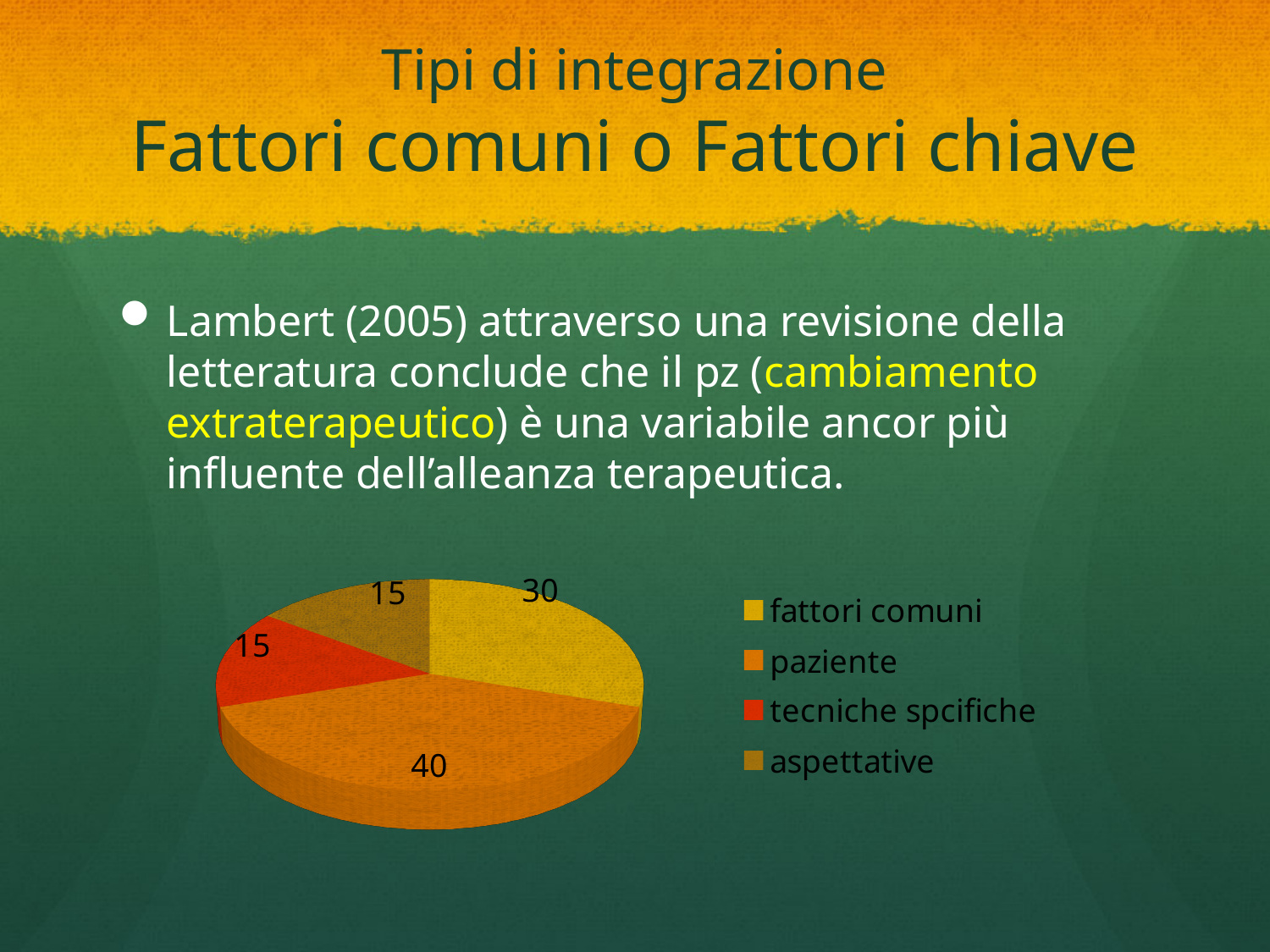
What share of the pie does the paziente slice represent? 40% What kind of chart is shown on the slide? pie chart What value is shown for the aspettative slice of the pie chart? 15 Which is larger, the value for fattori comuni or the value for paziente? paziente What value is shown for the tecniche spcifiche slice of the pie chart? 15 What value is shown for the fattori comuni slice of the pie chart? 30 Which legend entry is shown in red in the pie chart? tecniche spcifiche Which category has the largest slice in the pie chart? paziente What value is shown for the paziente slice of the pie chart? 40 What is the difference between the values for paziente and fattori comuni? 10 How many categories does the pie chart show? 4 What is the total of all the values shown in the pie chart? 100